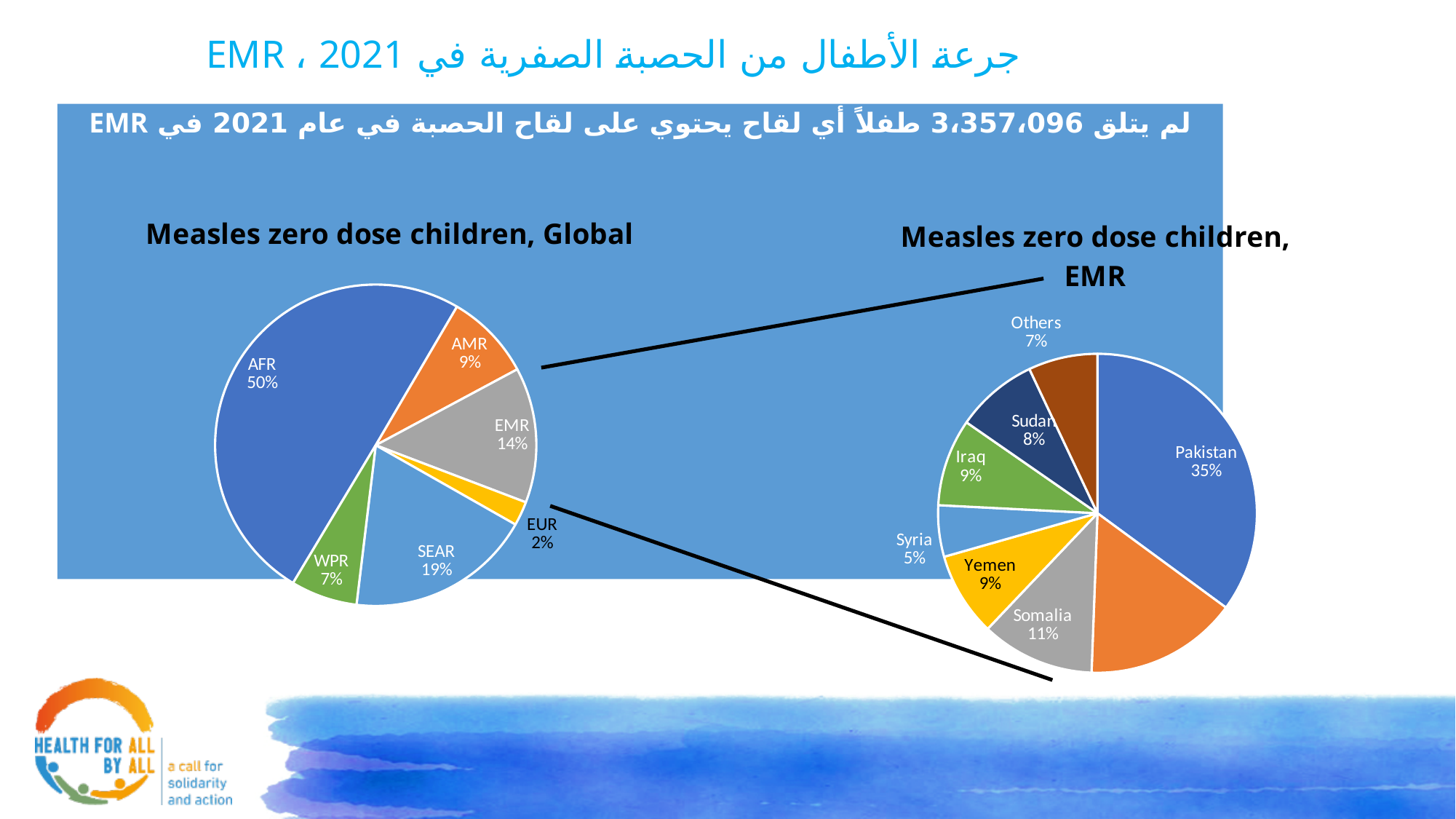
In the 'Measles zero dose children, EMR' chart, what share does Pakistan have? 35% In the 'Measles zero dose children, EMR' chart, what share does Somalia have? 11% In the 'Measles zero dose children, Global' chart, which region has the largest share? AFR In the 'Measles zero dose children, Global' chart, what is the difference between the SEAR and WPR shares? 12% In the 'Measles zero dose children, Global' chart, how many regions are shown? 6 What type of chart is 'Measles zero dose children, EMR'? Pie chart In the 'Measles zero dose children, EMR' chart, what is the difference between the Pakistan and Iraq shares? 26% In the 'Measles zero dose children, Global' chart, what share does AFR have? 50% In the 'Measles zero dose children, Global' chart, what colour is the EMR slice? Grey In the 'Measles zero dose children, Global' chart, which region has the smallest share? EUR In the 'Measles zero dose children, EMR' chart, which is larger, the share for Sudan or the share for Syria? Sudan In the 'Measles zero dose children, Global' chart, what share does EMR have? 14%